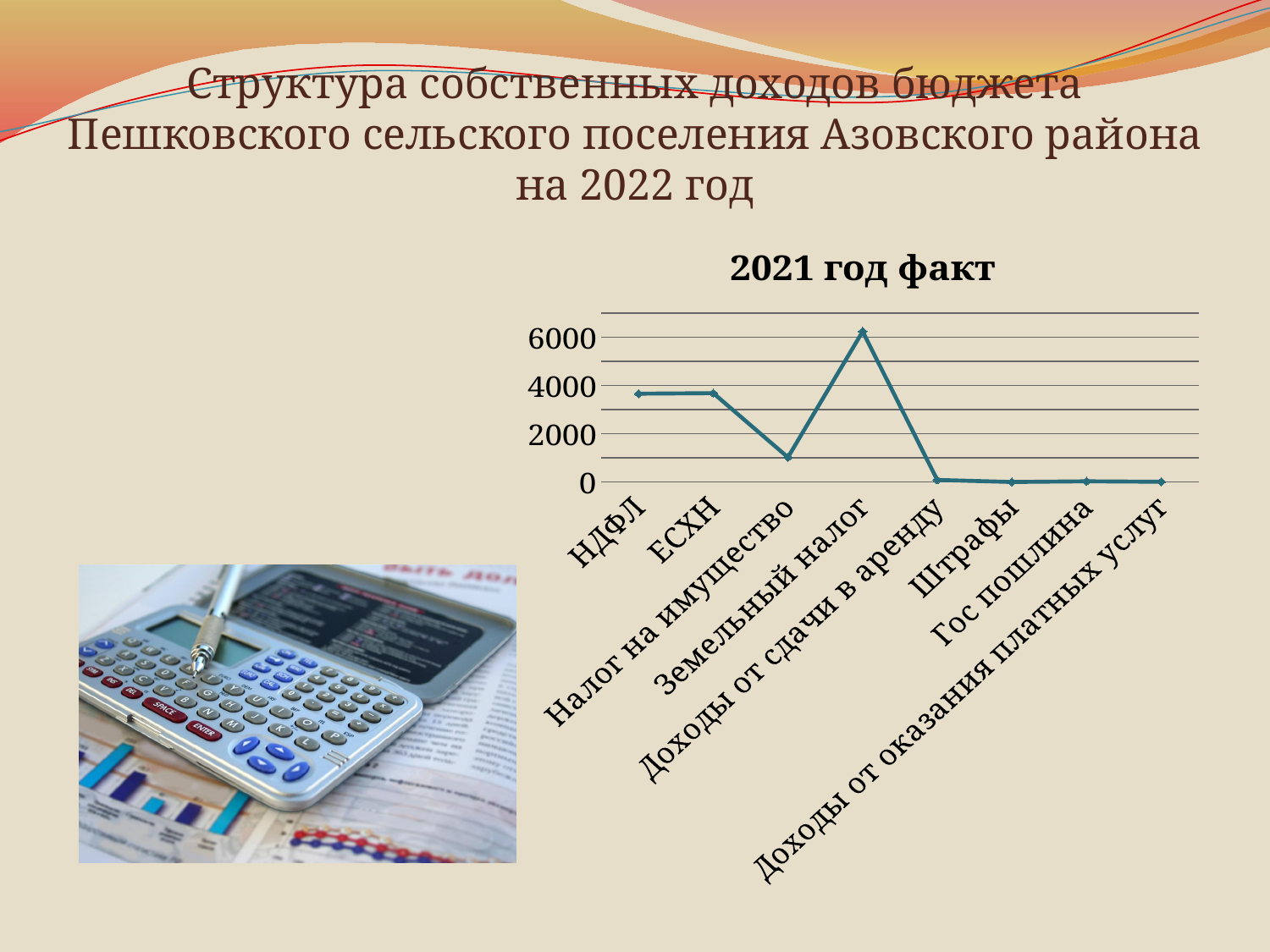
How many categories are plotted along the x axis of the chart? 8 What is the title of the chart? 2021 год факт Which is larger, the value for Земельный налог or the value for Налог на имущество? Земельный налог What kind of chart is shown on the slide? line chart Is the value for Налог на имущество greater or less than 2000? less Is the value for Земельный налог greater or less than 4000? greater Is the value for Штрафы greater or less than 2000? less Which category has the highest value in the chart? Земельный налог Which is larger, the value for ЕСХН or the value for Гос пошлина? ЕСХН What is the highest value labelled on the y axis of the chart? 6000 Does the line rise or fall from Земельный налог to Доходы от сдачи в аренду? fall